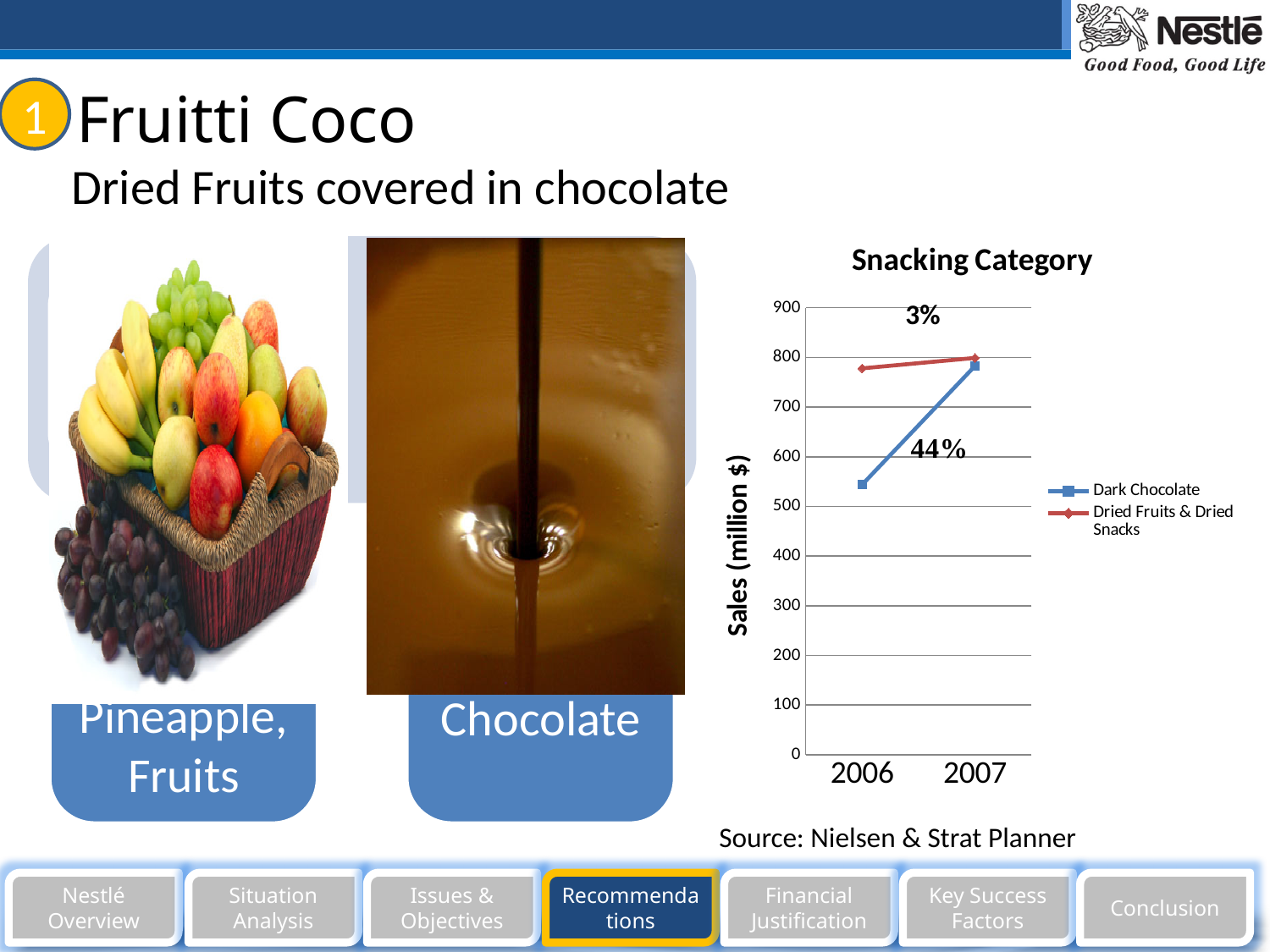
Is the Dried Fruits & Dried Snacks value for 2006 greater or less than 700? greater What is the label on the y axis of the Snacking Category chart? Sales (million $) Is the Dark Chocolate value for 2007 greater or less than 700? greater What percentage is labelled on the Dried Fruits & Dried Snacks line in the Snacking Category chart? 3% Is the Dark Chocolate value for 2006 greater or less than 500? greater In 2006, which series has the larger value: Dark Chocolate or Dried Fruits & Dried Snacks? Dried Fruits & Dried Snacks Does the Dark Chocolate line rise or fall from 2006 to 2007? rise What type of chart is shown under the title "Snacking Category"? line chart How many series does the legend of the Snacking Category chart list? 2 What percentage is labelled on the Dark Chocolate line in the Snacking Category chart? 44% How many years are shown on the x axis of the Snacking Category chart? 2